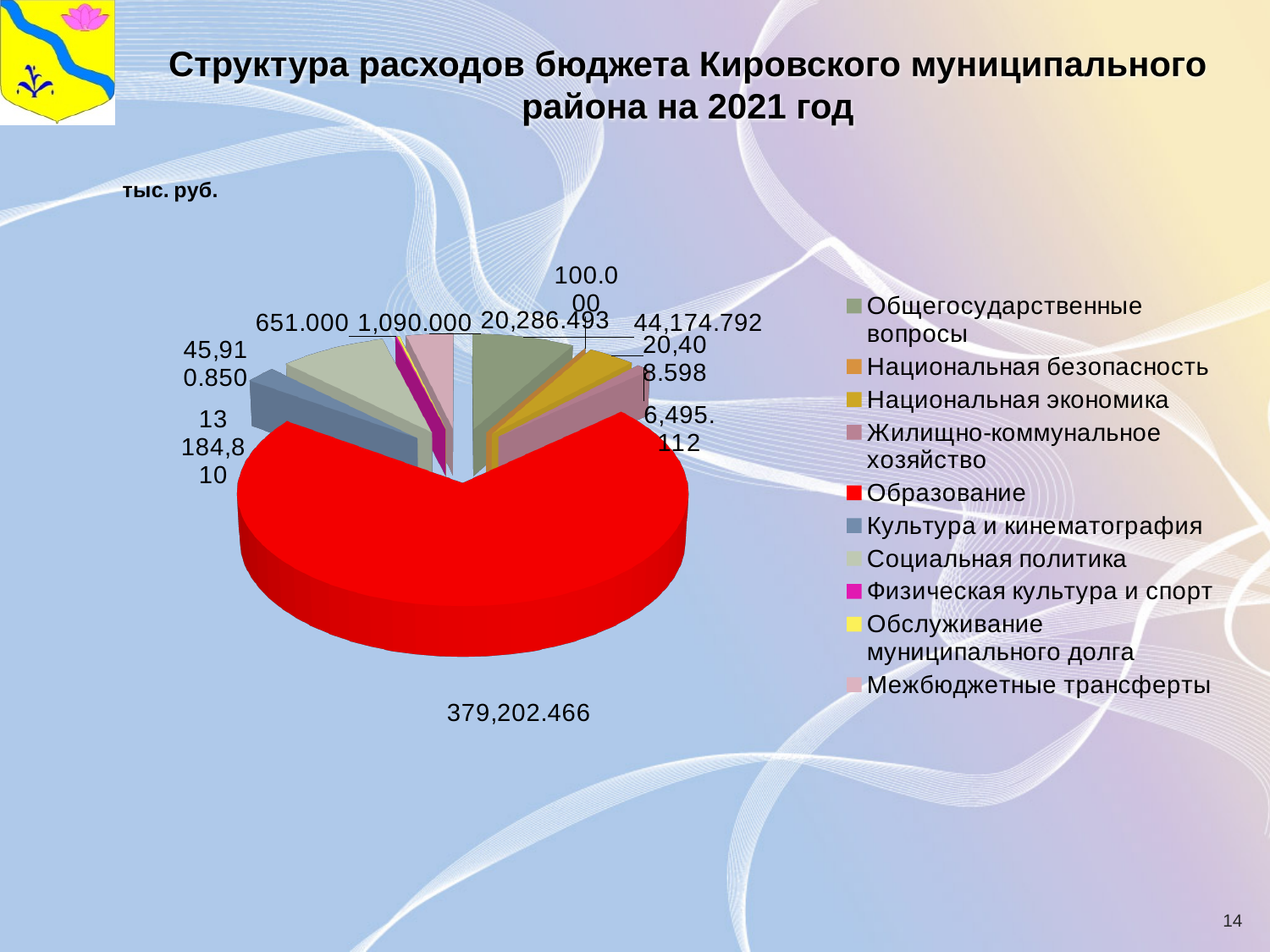
Which is larger: Социальная политика or Общегосударственные вопросы? Социальная политика What is the value shown for Образование? 379,202.466 What is the value shown for Жилищно-коммунальное хозяйство? 6,495.112 What is the value shown for Национальная безопасность? 100.000 Which category has the largest slice of the pie? Образование What type of chart is shown on the slide? pie chart How many categories does the legend of the pie chart list? 10 What is the value shown for Социальная политика? 45,910.850 What is the value shown for Национальная экономика? 20,408.598 What is the value shown for Общегосударственные вопросы? 44,174.792 In what units are the values on the chart given, according to the slide? тыс. руб. What is the difference between the values for Национальная экономика and Жилищно-коммунальное хозяйство? 13,913.486